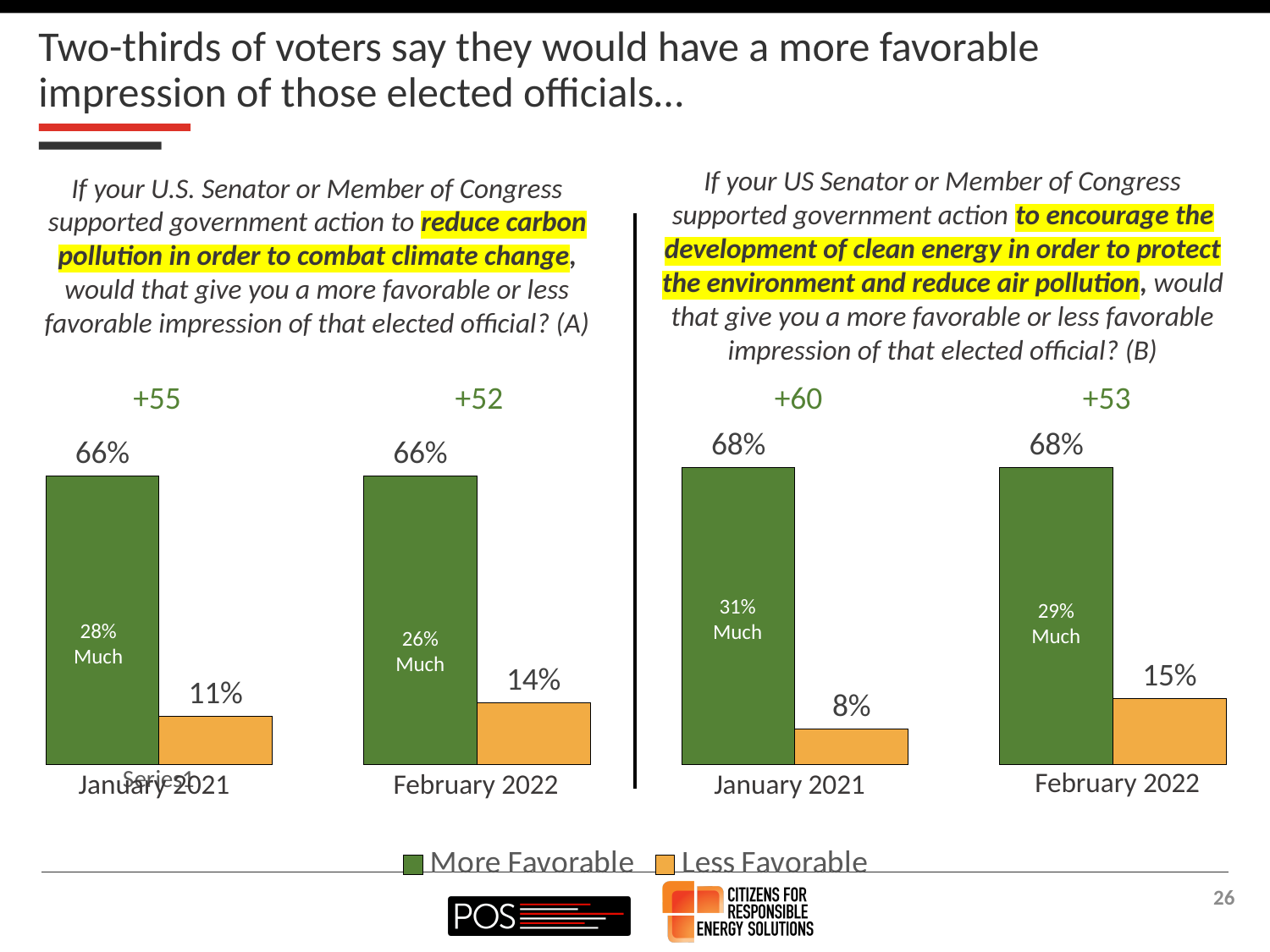
In the right chart (clean energy), what is the More Favorable value for February 2022? 68% In the right chart (clean energy), what is the Less Favorable value for January 2021? 8% In the right chart (clean energy), what is the difference between the Less Favorable values for February 2022 and January 2021? 7 percentage points In the left chart (reduce carbon pollution), does the Less Favorable value rise or fall from January 2021 to February 2022? Rise In the left chart (reduce carbon pollution), what is the More Favorable value for January 2021? 66% Which colour represents the More Favorable series in the legend? Green In the right chart (clean energy), which category has the lowest Less Favorable value? January 2021 In the left chart (reduce carbon pollution), what is the difference between the More Favorable and Less Favorable values for January 2021? 55 percentage points In the left chart (reduce carbon pollution), which is larger: the Less Favorable value for January 2021 or for February 2022? February 2022 What kind of chart is used on this slide? Bar chart How many series does the legend list? 2 In the left chart (reduce carbon pollution), what is the Less Favorable value for February 2022? 14%